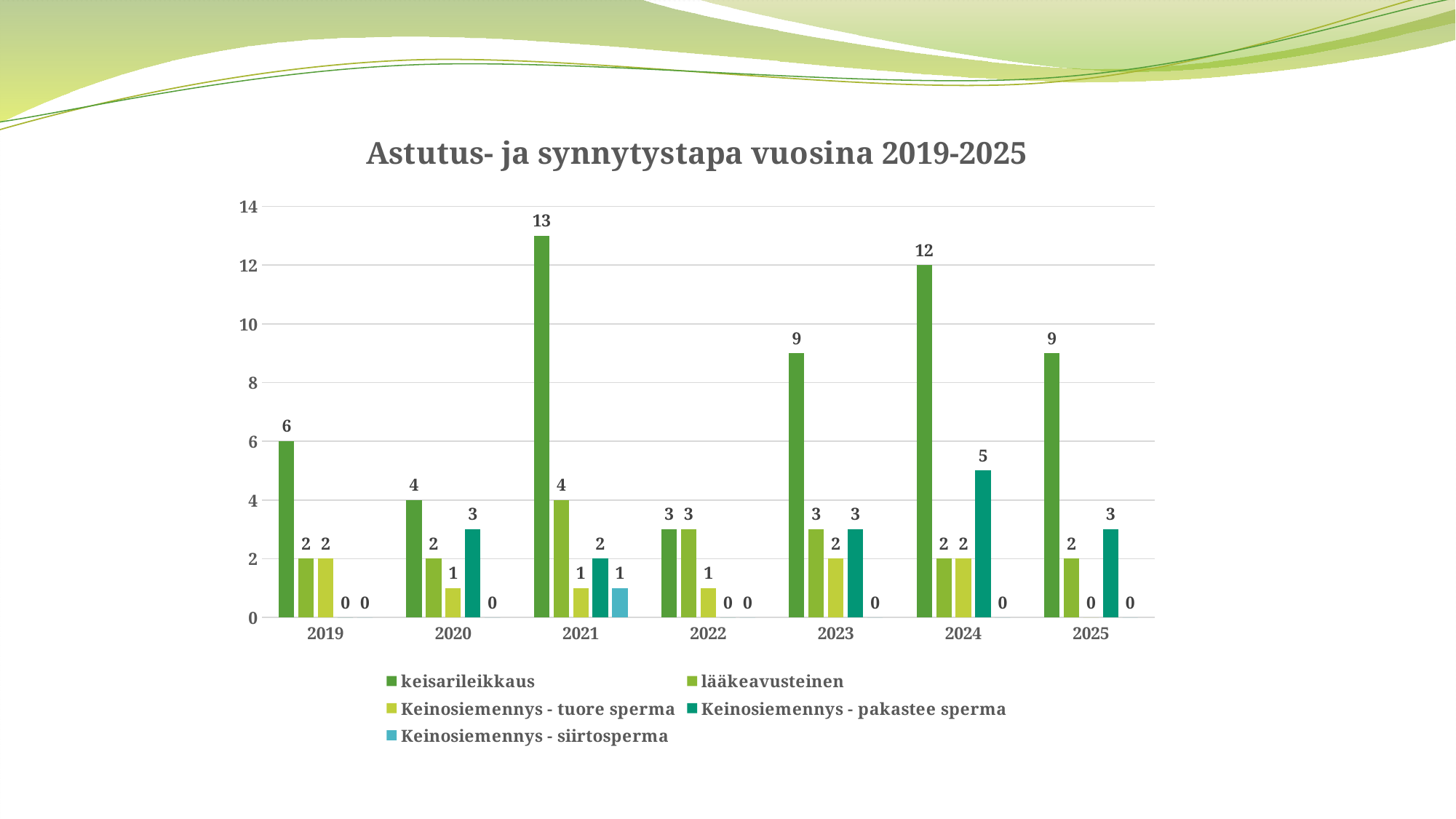
What is the value for lääkeavusteinen in 2021? 4 How many series does the legend list? 5 What is the value for Keinosiemennys - pakastee sperma in 2024? 5 In which year is the keisarileikkaus value highest? 2021 How many years are shown on the x axis? 7 In which year is the keisarileikkaus value lowest? 2022 What is the difference between the keisarileikkaus values in 2021 and 2024? 1 In which year does Keinosiemennys - siirtosperma have a non-zero value? 2021 What type of chart is shown on the slide? bar chart What is the title of the chart? Astutus- ja synnytystapa vuosina 2019-2025 Which is larger in 2020: lääkeavusteinen or Keinosiemennys - pakastee sperma? Keinosiemennys - pakastee sperma What is the value for keisarileikkaus in 2021? 13